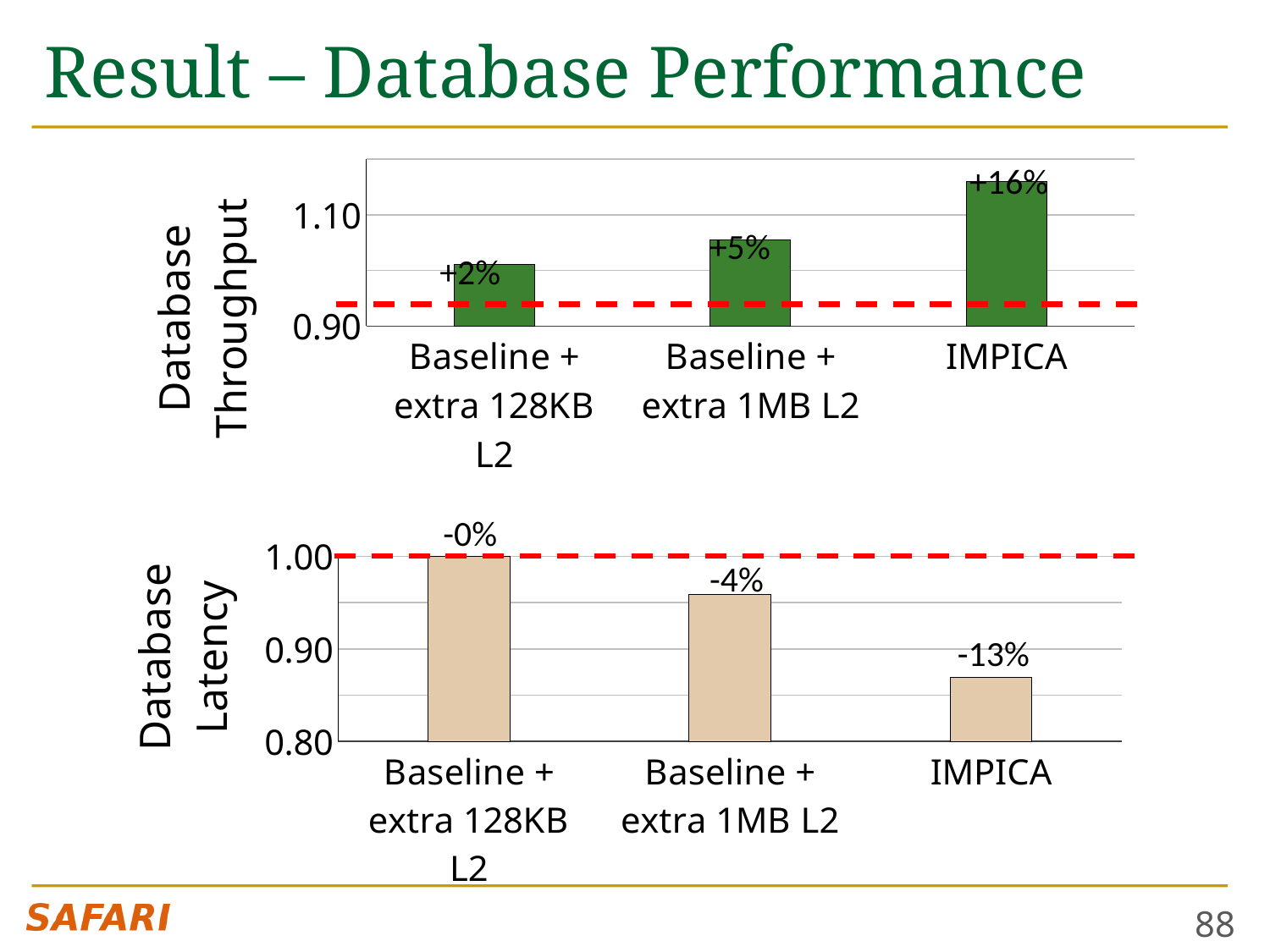
In the Database Throughput chart (top), what is the data label on the Baseline + extra 1MB L2 bar? +5% In the Database Throughput chart (top), what is the data label on the IMPICA bar? +16% How many categories are shown in the Database Throughput chart (top)? 3 In the Database Latency chart (bottom), which bar is taller: Baseline + extra 1MB L2 or IMPICA? Baseline + extra 1MB L2 In the Database Throughput chart (top), is the value for IMPICA greater or less than 1.10? greater In the Database Throughput chart (top), which category has the highest bar? IMPICA In the Database Latency chart (bottom), what is the data label on the Baseline + extra 128KB L2 bar? -0% In the Database Latency chart (bottom), is the value for IMPICA greater or less than 0.90? less What kind of chart is the Database Latency chart (bottom)? Bar chart In the Database Latency chart (bottom), do the bar values rise or fall from left to right? Fall In the Database Latency chart (bottom), which category has the lowest bar? IMPICA In the Database Latency chart (bottom), what is the data label on the IMPICA bar? -13%